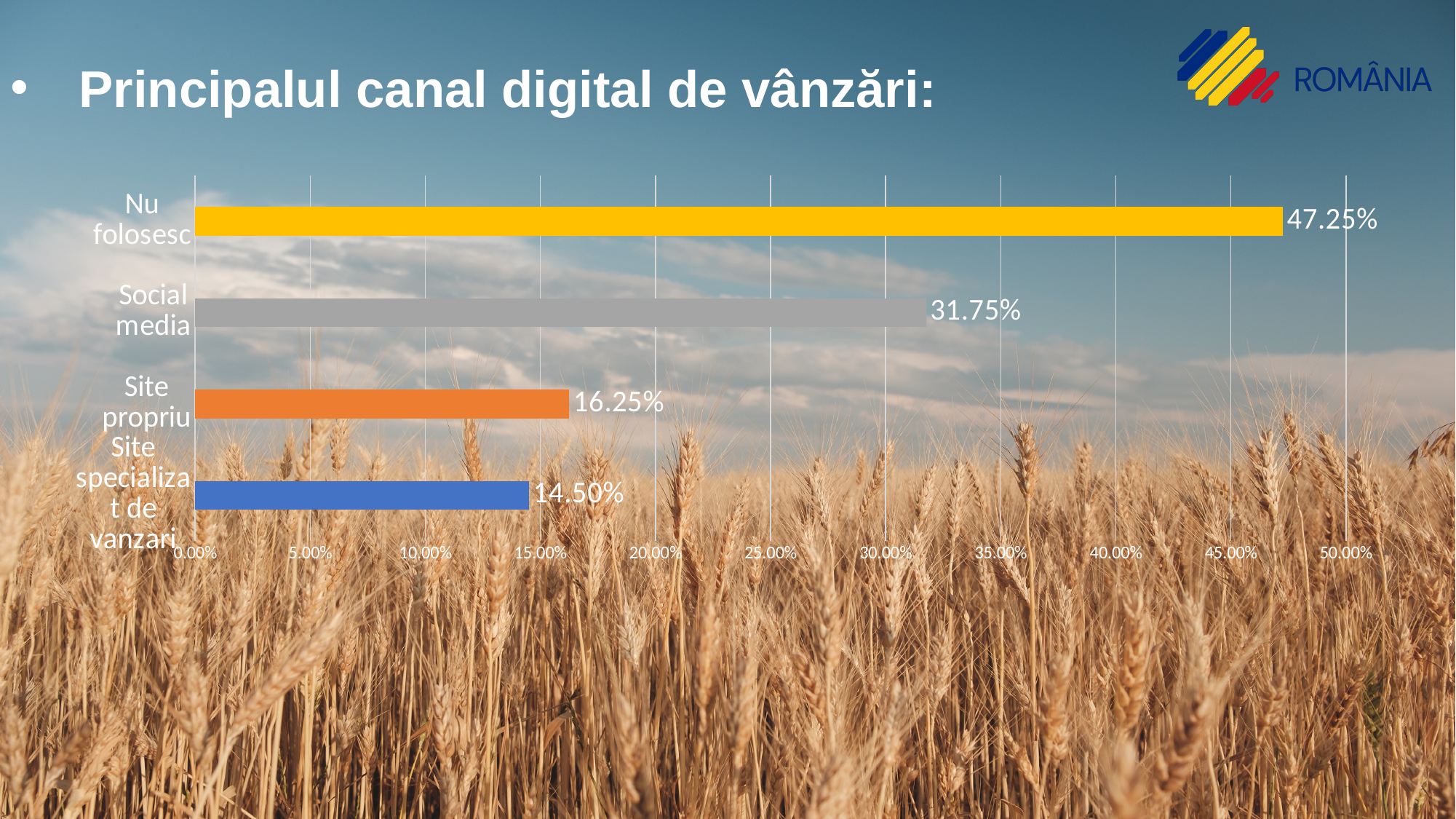
Is the value for Social media greater or less than 30.00%? greater What is the value for Nu folosesc? 47.25% What kind of chart is shown on the slide? Bar chart Which category has the highest value? Nu folosesc What is the difference between the values for Nu folosesc and Social media? 15.50% What is the value for Site propriu? 16.25% How many categories are shown in the chart? 4 Which is larger, the value for Social media or the value for Site propriu? Social media What is the value for Social media? 31.75% What is the value for Site specializat de vanzari? 14.50% Which category has the lowest value? Site specializat de vanzari What is the difference between the values for Site propriu and Site specializat de vanzari? 1.75%